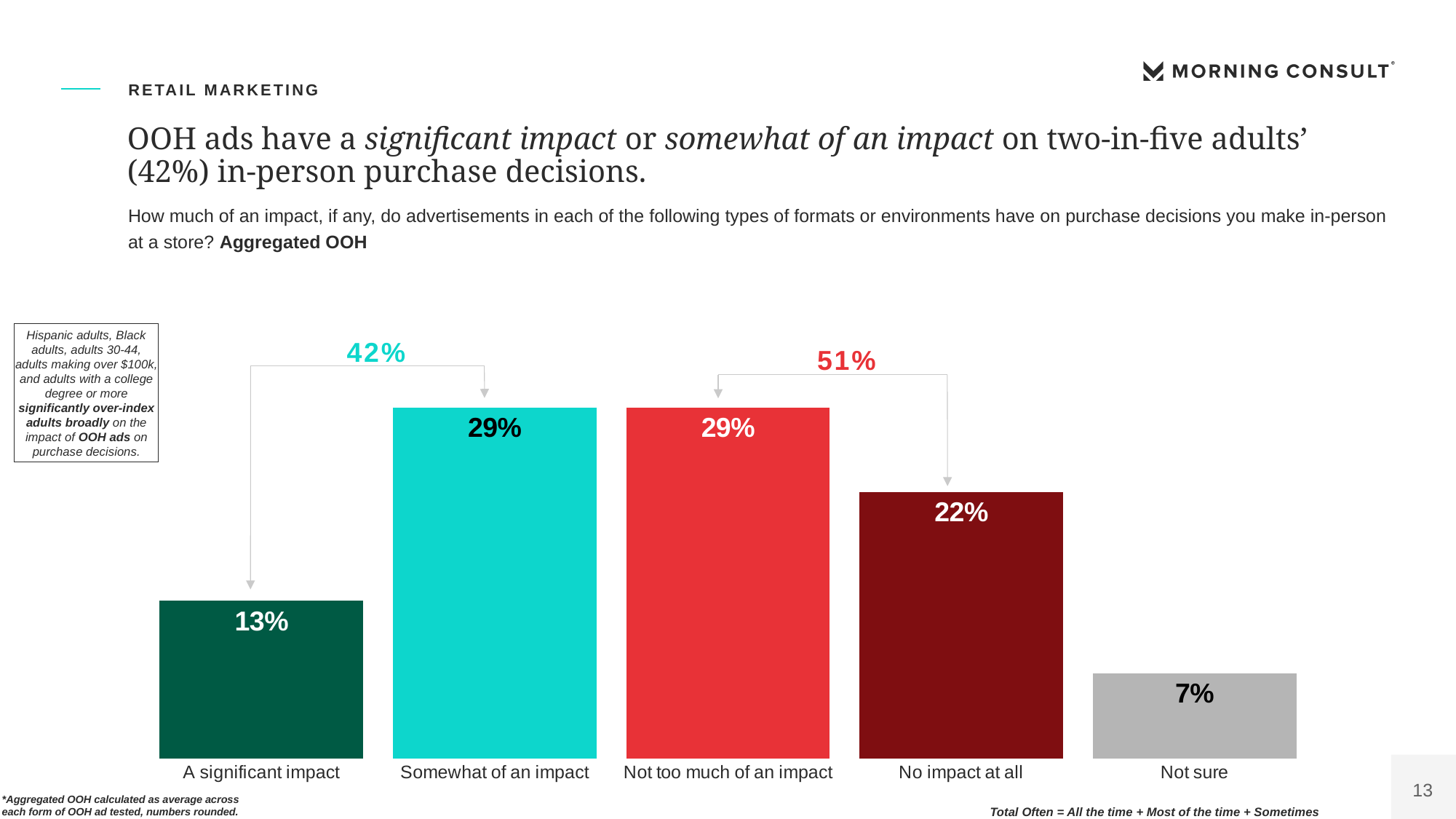
How many categories are shown in the chart? 5 What is the value shown for "Somewhat of an impact"? 29% What percentage of adults say OOH ads have a significant impact on their in-person purchase decisions? 13% What colour is the bar for "Not sure"? Gray Which is larger, the value for "No impact at all" or the value for "A significant impact"? No impact at all What combined percentage is shown by the bracket over "Not too much of an impact" and "No impact at all"? 51% What is the value shown for "No impact at all"? 22% What kind of chart is shown on the slide? Bar chart What combined percentage is shown by the bracket over "A significant impact" and "Somewhat of an impact"? 42% What is the value shown for "Not sure"? 7% Which category has the lowest value in the chart? Not sure What is the difference between the values for "No impact at all" and "A significant impact"? 9%